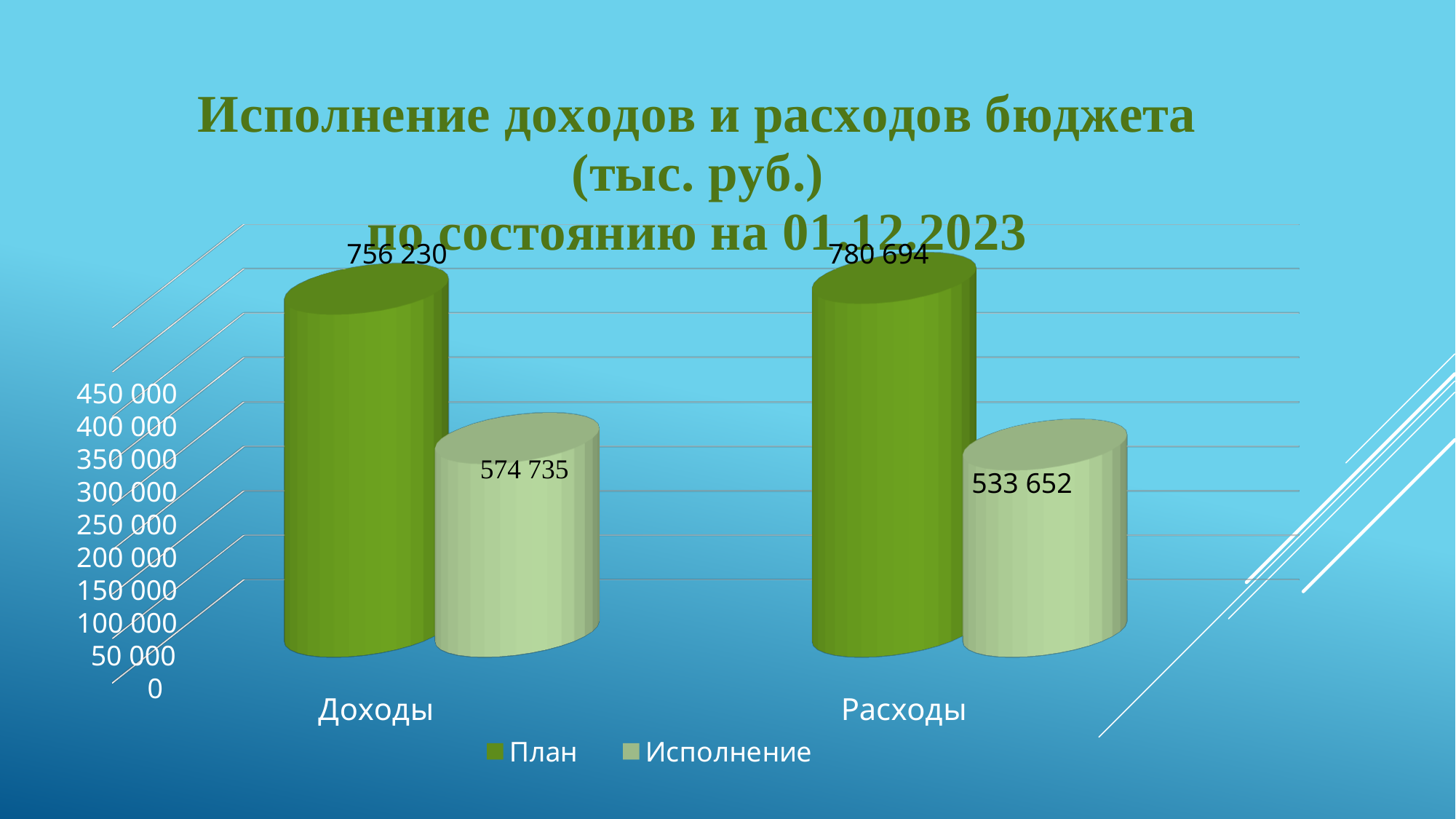
What is the difference between the План and Исполнение values for Доходы? 181 495 What is the Исполнение value for Доходы? 574 735 What is the Исполнение value for Расходы? 533 652 Which category has the higher План value, Доходы or Расходы? Расходы What is the difference between the План and Исполнение values for Расходы? 247 042 How many series does the legend list? 2 Which category has the lower Исполнение value? Расходы How many categories are shown on the x axis? 2 What is the План value for Расходы? 780 694 What is the План value for Доходы? 756 230 What kind of chart is shown on the slide? Bar chart Which series is shown in dark green in the legend? План